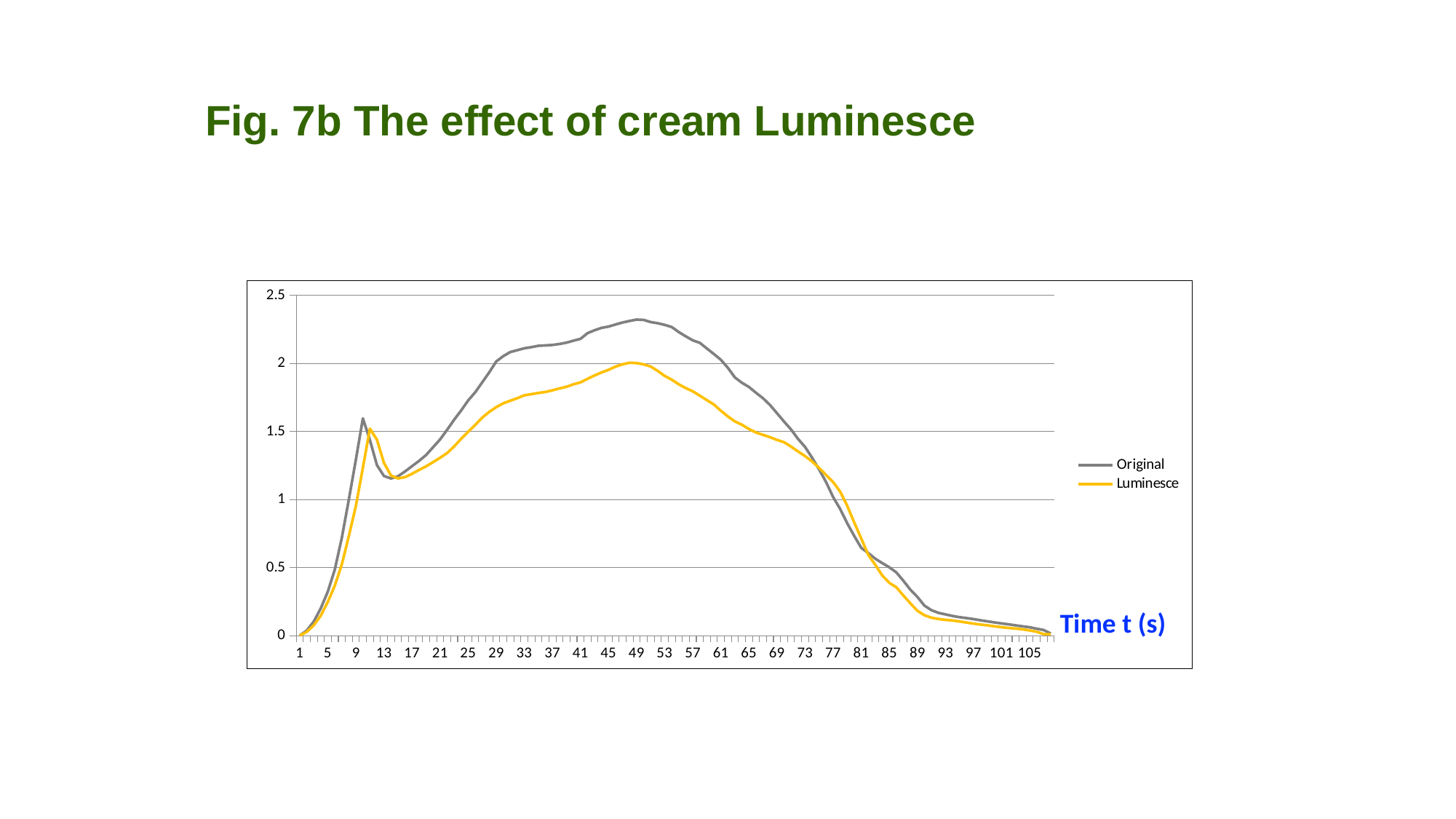
At time 49, which series has the larger value, Original or Luminesce? Original Is the value of the Luminesce series at time 89 greater or less than 0.5? less What is the label of the x axis? Time t (s) Which series reaches the higher peak value? Original At time 33, which series has the larger value, Original or Luminesce? Original Is the value of the Original series at time 65 greater or less than 1.5? greater How many series does the legend list? 2 What are the two series named in the legend? Original and Luminesce Is the value of the Luminesce series at time 33 greater or less than 1.5? greater What kind of chart is shown on the slide? line chart Between time 49 and time 89, do the values of the Original series rise or fall? fall